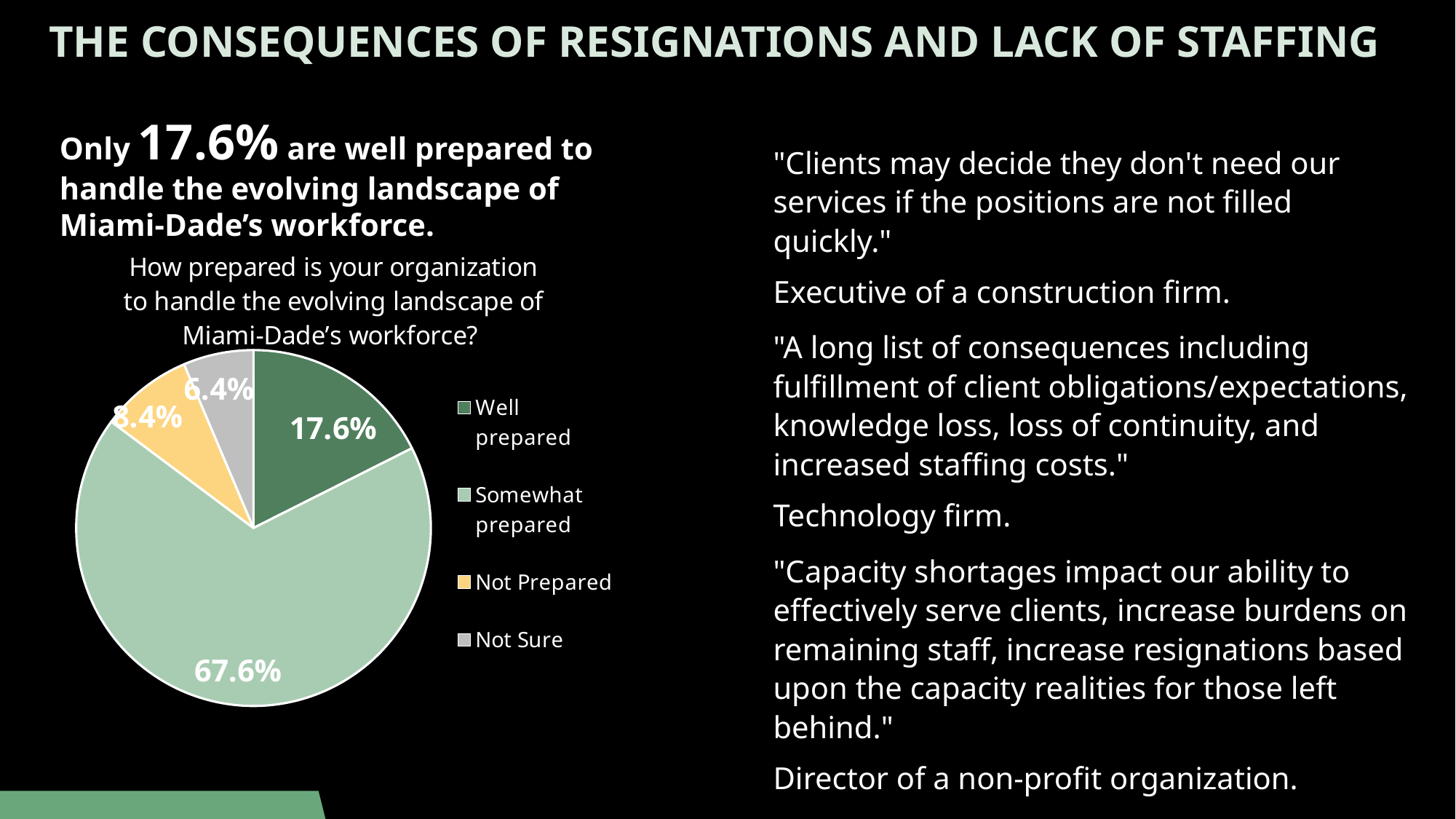
What percentage of organizations are not prepared? 8.4% What is the difference in percentage points between somewhat prepared and well prepared? 50 percentage points Which category has the largest share of the pie? Somewhat prepared What colour represents the not prepared slice? yellow What is the title of the pie chart? How prepared is your organization to handle the evolving landscape of Miami-Dade's workforce? What percentage of organizations are well prepared? 17.6% Which category has the smallest share of the pie? Not Sure Which is larger, the share for not prepared or the share for not sure? Not Prepared What percentage of organizations are somewhat prepared? 67.6% How many categories does the pie chart show? 4 What kind of chart is shown on the slide? pie chart What percentage of organizations answered not sure? 6.4%